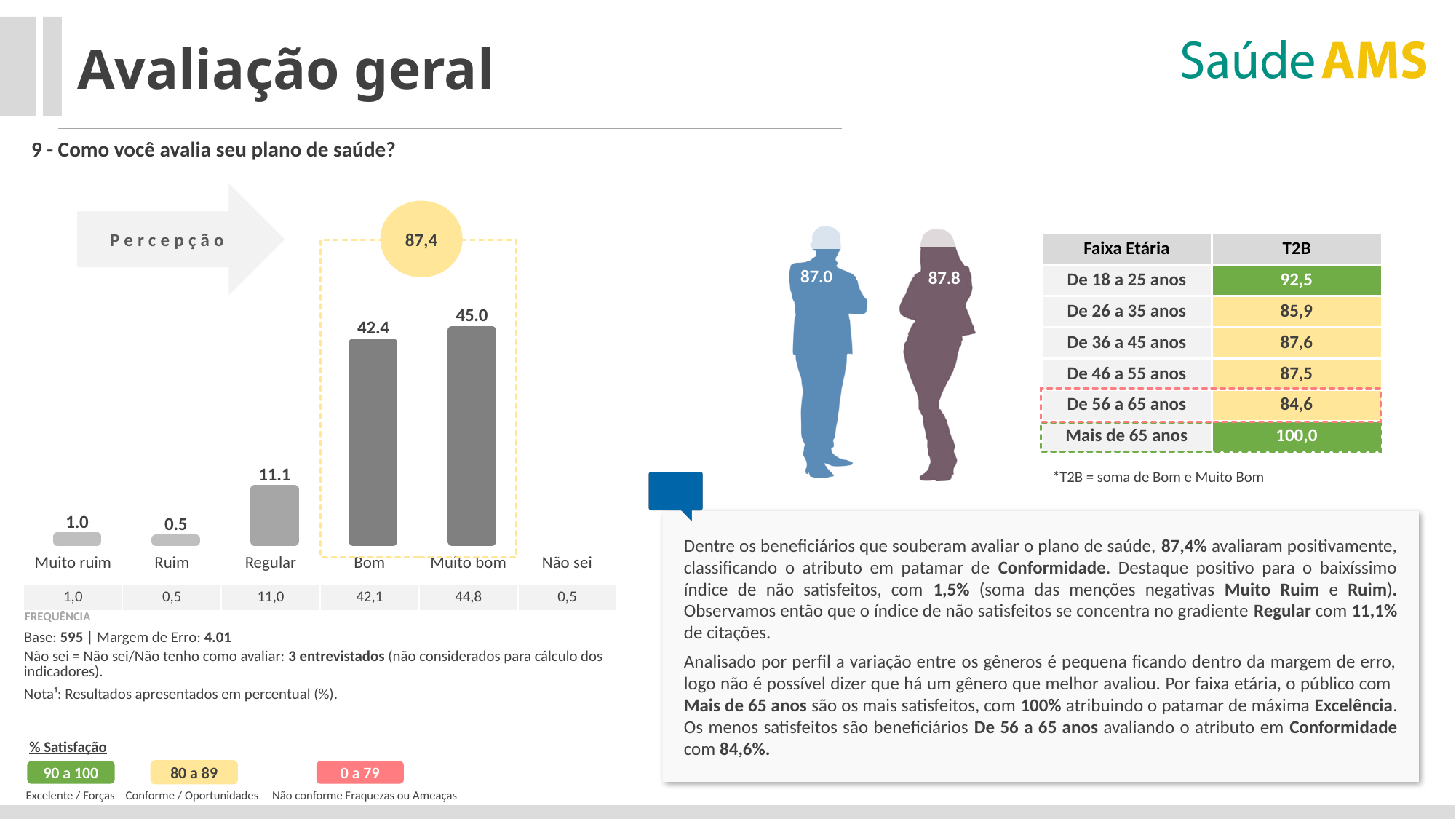
In the bar chart, what is the value for Muito bom? 45.0 How many categories are labeled along the x axis of the bar chart? 6 In the bar chart, which is larger, the value for Muito ruim or the value for Ruim? Muito ruim In the bar chart, what is the value for Bom? 42.4 In the bar chart, what is the value for Regular? 11.1 In the bar chart, what is the value for Muito ruim? 1.0 In the bar chart, which category has the shortest bar? Ruim In the bar chart, which category has the highest value? Muito bom In the bar chart, what is the difference between the values for Regular and Muito ruim? 10.1 What kind of chart is shown on the left of the slide? Bar chart In the bar chart, what is the difference between the values for Muito bom and Bom? 2.6 What value is shown in the yellow circle above the Bom and Muito bom bars? 87,4